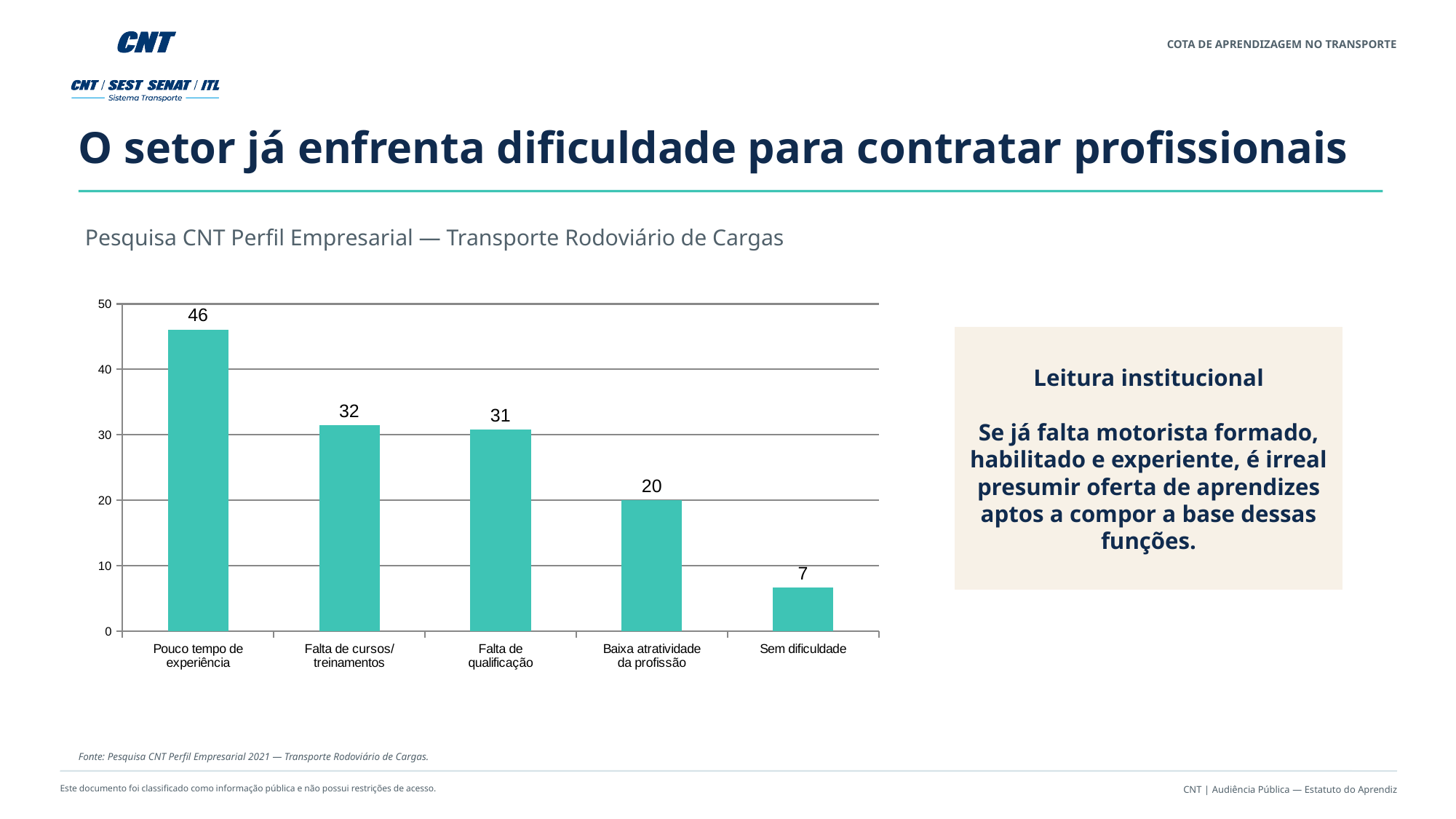
What is the value for "Pouco tempo de experiência"? 46 Do the values rise or fall from left to right along the x axis? Fall What is the value for "Falta de cursos/ treinamentos"? 32 Which category has the lowest value? Sem dificuldade What kind of chart is shown on the slide? Bar chart Which category has the highest value? Pouco tempo de experiência What is the difference between the values for "Pouco tempo de experiência" and "Falta de qualificação"? 15 How many categories are shown on the chart? 5 Which is larger, the value for "Falta de qualificação" or the value for "Baixa atratividade da profissão"? Falta de qualificação What is the value for "Sem dificuldade"? 7 What is the value for "Baixa atratividade da profissão"? 20 Is the value for "Falta de cursos/ treinamentos" greater or less than 30? greater